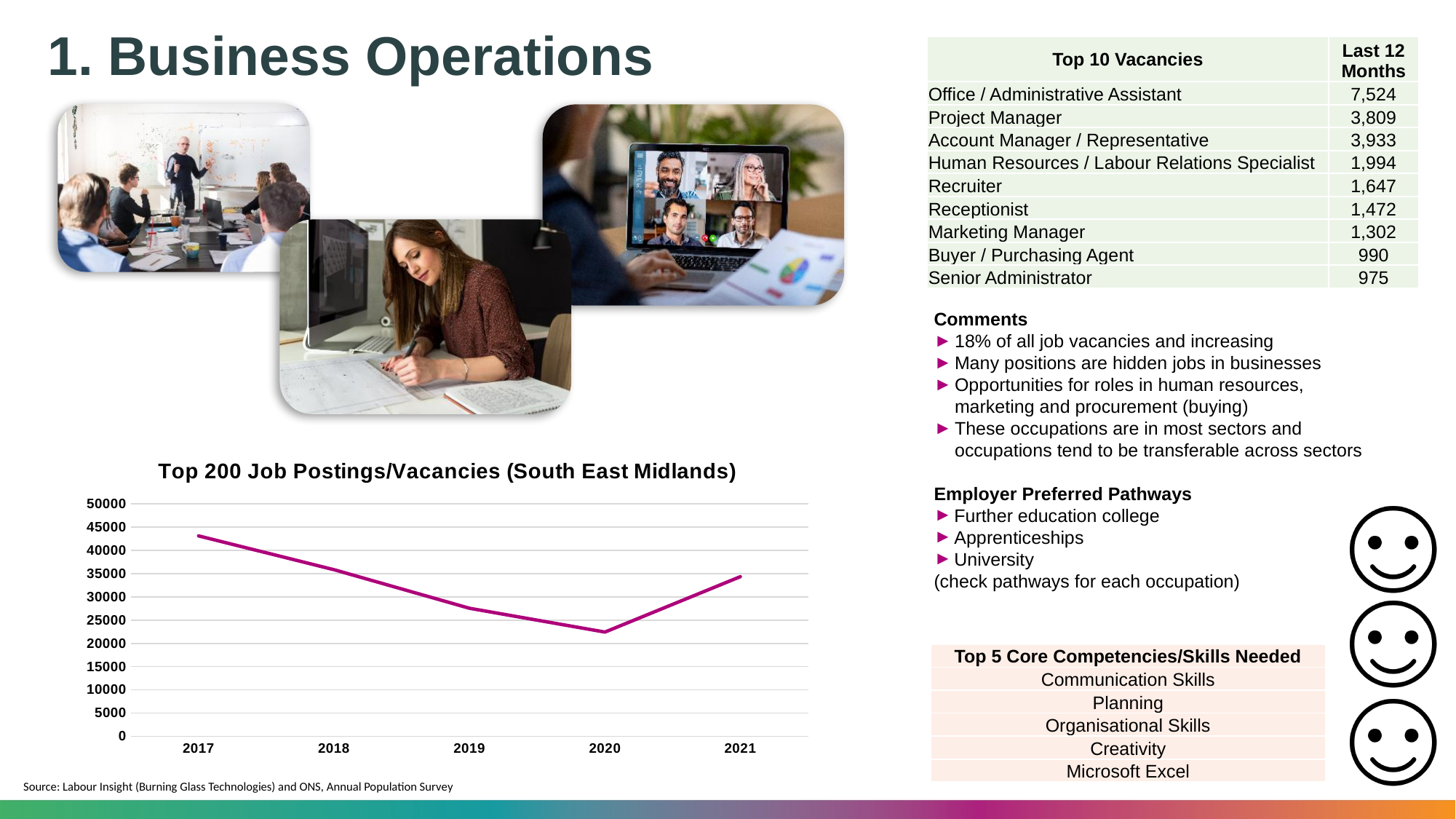
Is the value for 2021 greater or less than 30000? greater Is the value for 2017 greater or less than 40000? greater How many years are plotted on the x axis of the chart? 5 Is the value for 2019 greater or less than 25000? greater Do the values rise or fall from 2017 to 2020? fall Which year has the lowest value in the chart? 2020 Which is larger, the value for 2019 or the value for 2020? 2019 Which year has the highest value in the chart? 2017 Which is larger, the value for 2017 or the value for 2021? 2017 What is the title of the chart? Top 200 Job Postings/Vacancies (South East Midlands) What type of chart is shown on the slide? line chart